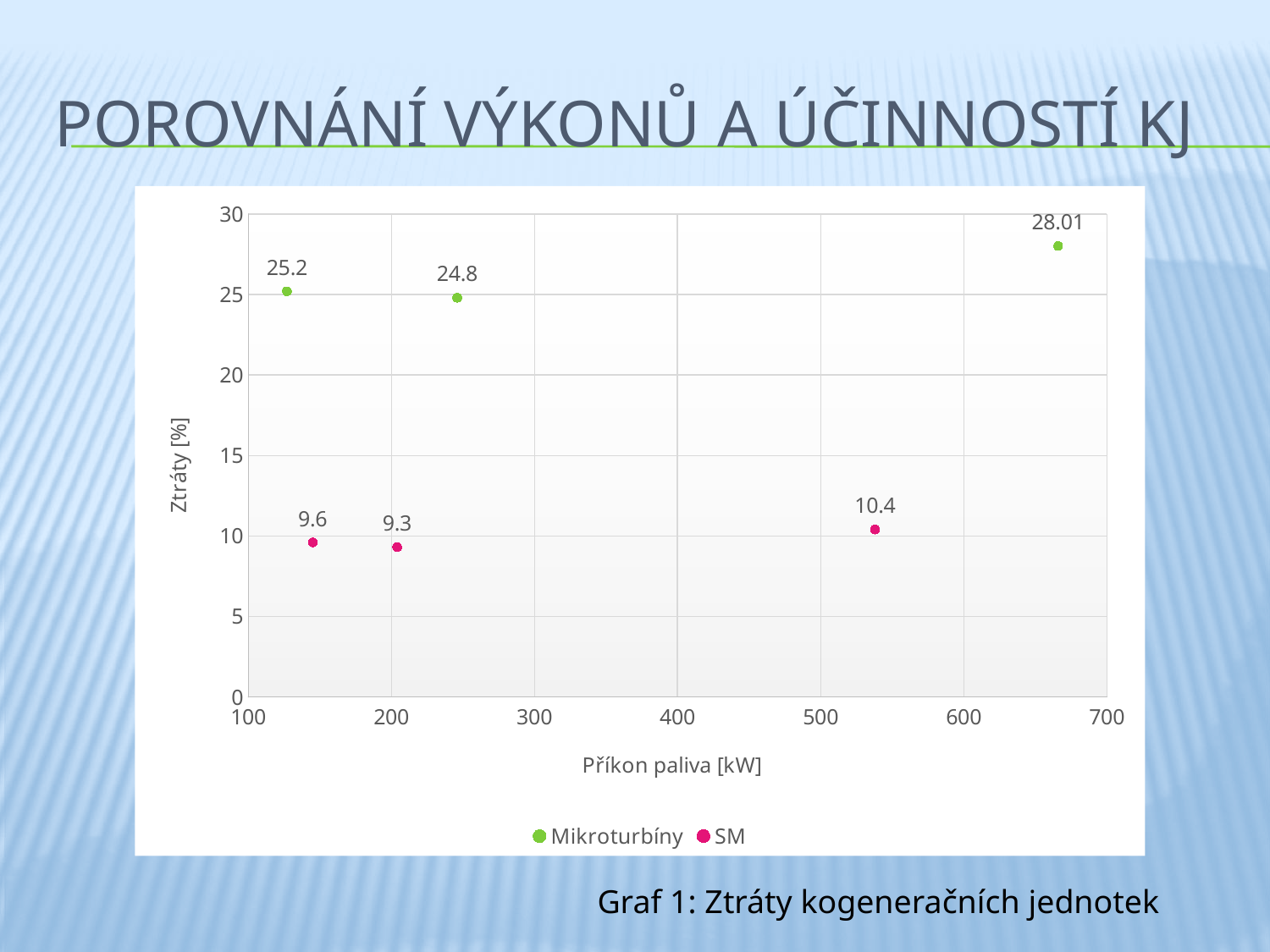
Which series has higher loss values overall, Mikroturbíny or SM? Mikroturbíny What is the difference between the highest Mikroturbíny value (28.01) and the lowest Mikroturbíny value (24.8)? 3.21 What is the loss value labelled for the Mikroturbíny point with the highest fuel input (rightmost point)? 28.01 What is the highest loss value labelled on the chart? 28.01 What is the lowest loss value labelled on the chart? 9.3 How many data points are plotted in total on the chart? 6 How many data points belong to the SM series? 3 What is the title of the vertical axis? Ztráty [%] What kind of chart is shown on the slide? scatter chart Is the fuel input (Příkon paliva) of the SM point labelled 10.4 greater or less than 500 kW? greater How many series does the legend list? 2 What is the loss value labelled for the SM point with the highest fuel input (rightmost pink point)? 10.4